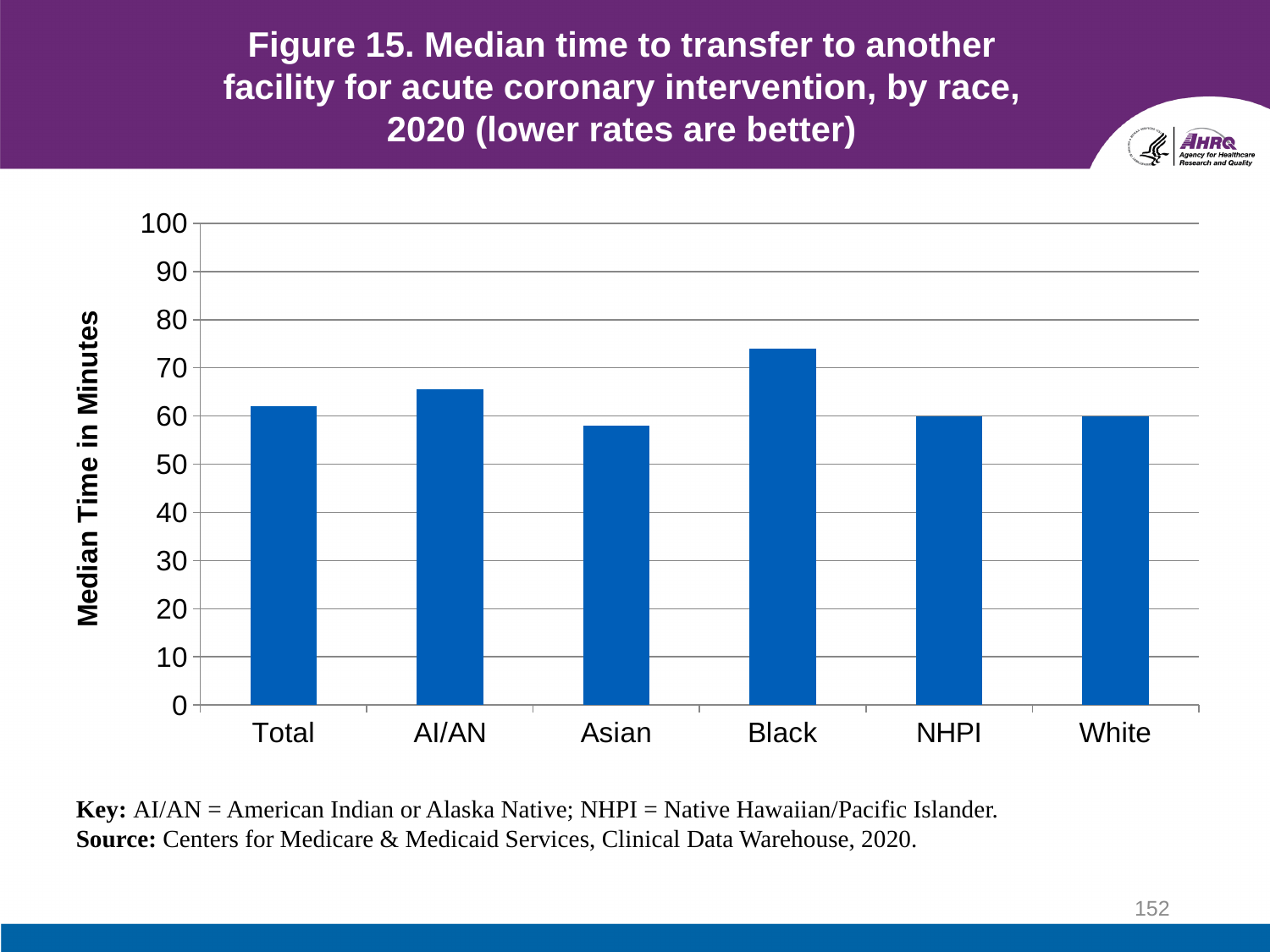
How many categories are shown on the x axis of the chart? 6 Is the median time for AI/AN greater or less than 60 minutes? greater What kind of chart is shown on the slide? bar chart Which is larger, the median time for Black or for White? Black Is the median time for Black greater or less than 80 minutes? less Is the median time for Asian greater or less than 60 minutes? less Which is larger, the median time for AI/AN or for Asian? AI/AN Which category has the highest median time to transfer? Black What is the label of the y axis of the chart? Median Time in Minutes Which is larger, the median time for Black or for Total? Black What year does the chart title say the data are from? 2020